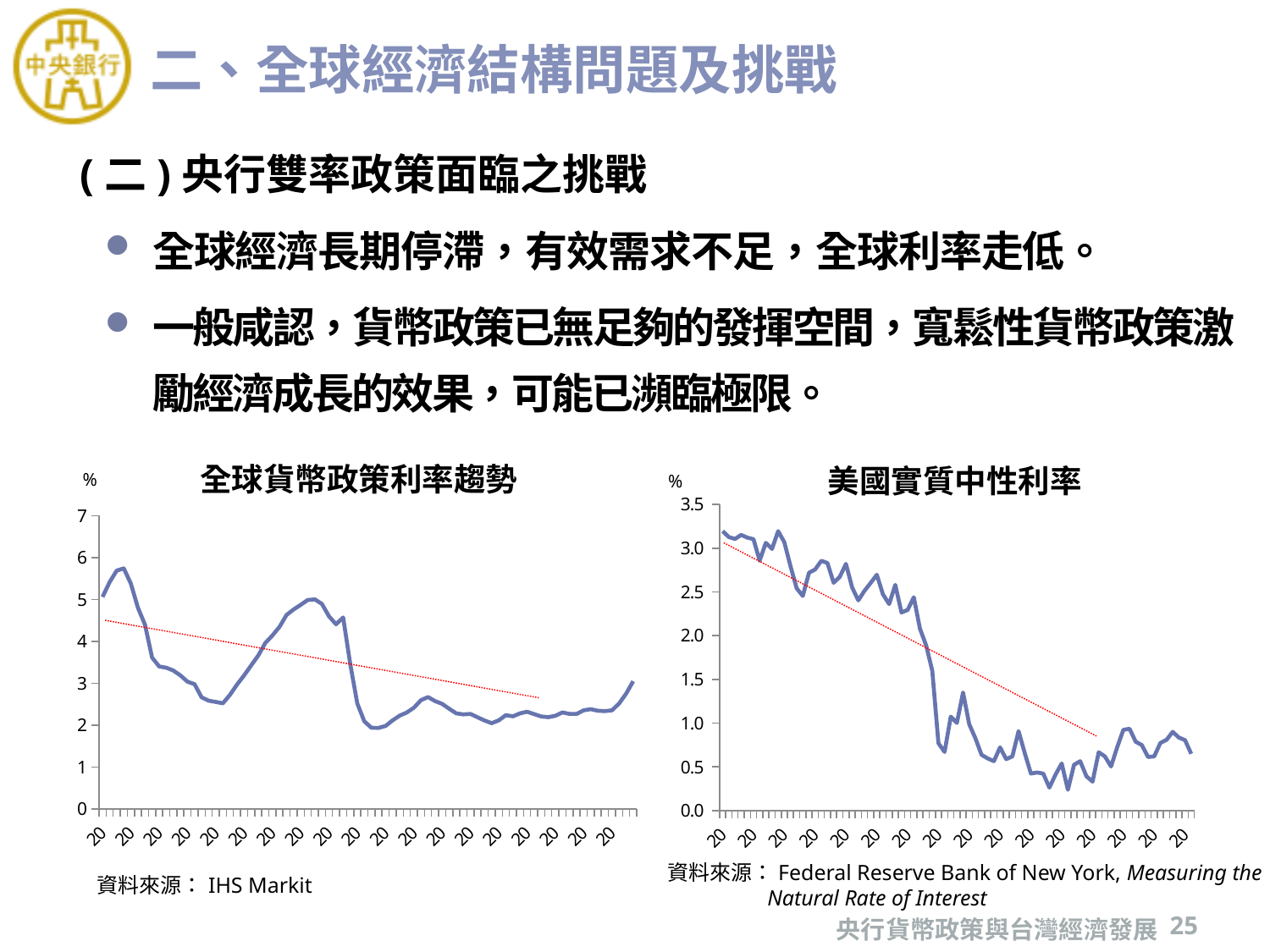
In the left chart (全球貨幣政策利率趨勢), do the values generally rise or fall along the x axis? fall In the right chart (美國實質中性利率), do the values generally rise or fall along the x axis? fall In the right chart (美國實質中性利率), is the value at the start of the series greater or less than 2.5? greater In the right chart (美國實質中性利率), is the lowest value of the line greater or less than 0.5? less In the left chart (全球貨幣政策利率趨勢), is the highest value of the line greater or less than 5? greater What kind of chart is the right chart titled 美國實質中性利率? line chart How many charts are shown on the slide? 2 What kind of chart is the left chart titled 全球貨幣政策利率趨勢? line chart What is the title of the left chart? 全球貨幣政策利率趨勢